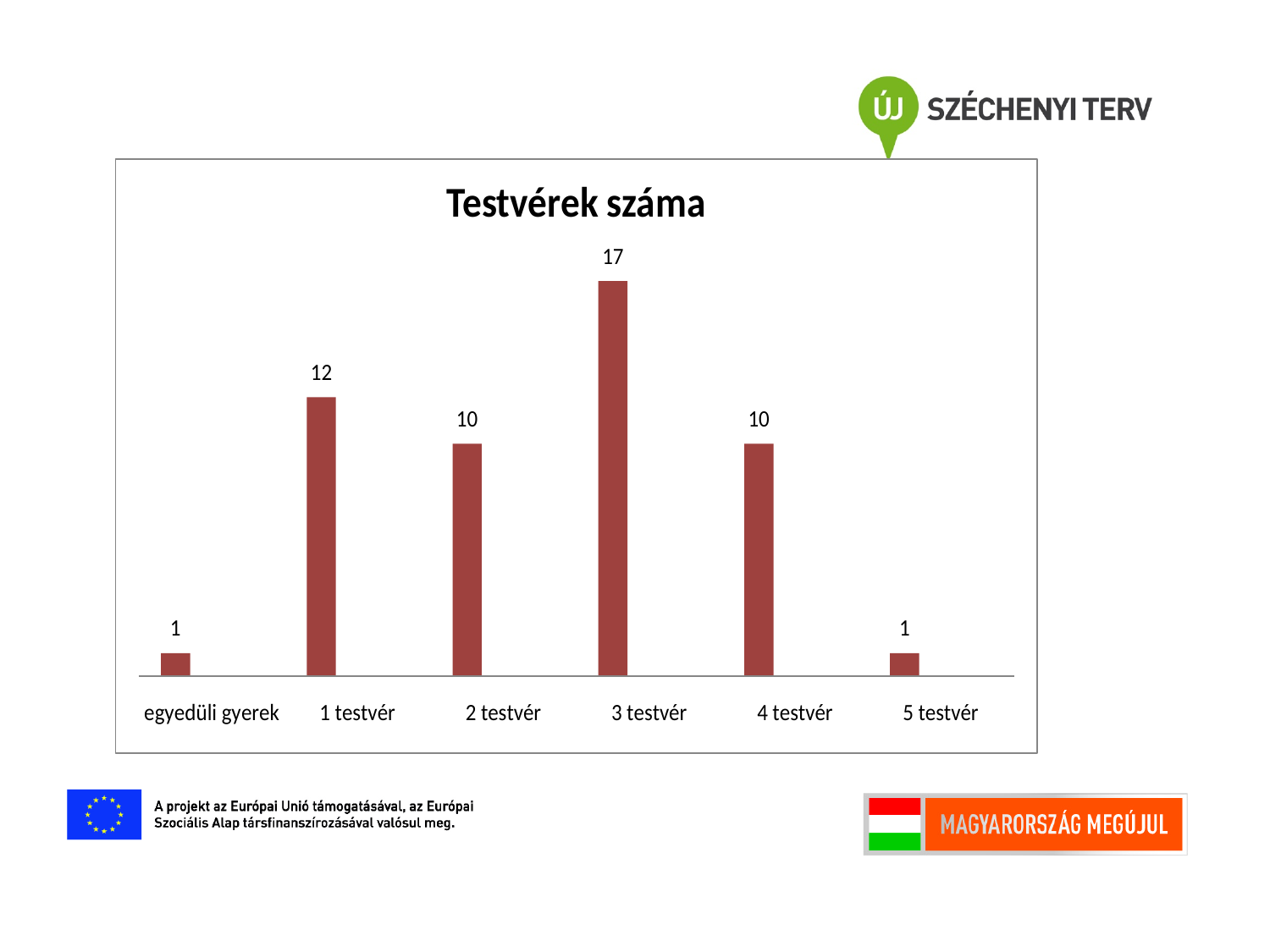
What is the value for "1 testvér"? 12 What is the value for "3 testvér"? 17 What kind of chart is shown on the slide? bar chart Which category has the highest value? 3 testvér What is the value for "5 testvér"? 1 Which is larger, the value for "1 testvér" or the value for "4 testvér"? 1 testvér Do the values for "2 testvér" and "4 testvér" differ? No, both are 10 What is the value for "egyedüli gyerek"? 1 What is the title of the chart? Testvérek száma What is the difference between the values for "3 testvér" and "1 testvér"? 5 What is the difference between the values for "1 testvér" and "2 testvér"? 2 How many categories are shown on the x axis? 6